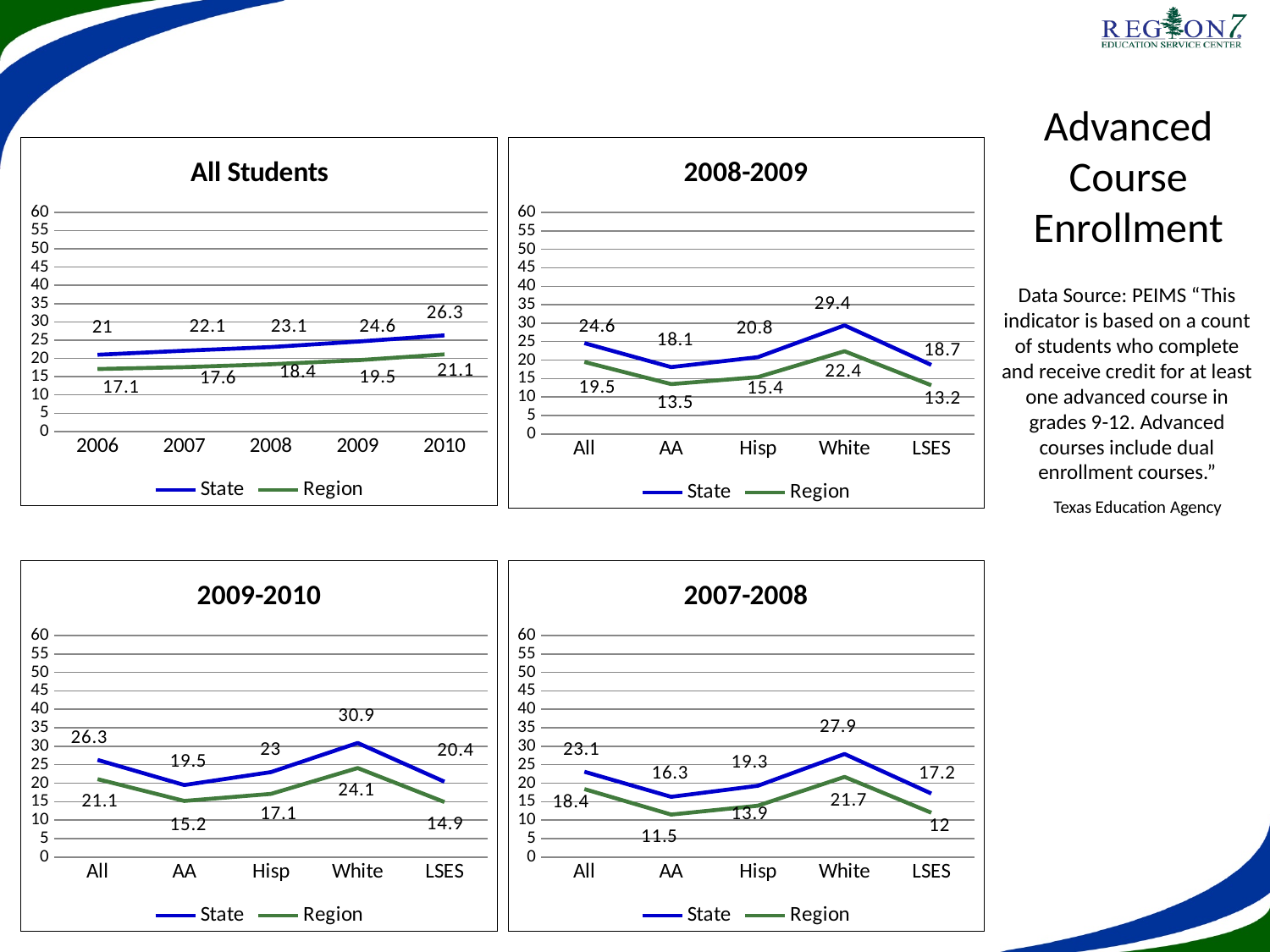
In the '2008-2009' chart, what is the difference between the State and Region values for All? 5.1 How many series does the legend of the '2007-2008' chart list? 2 In the 'All Students' chart, what is the State value for 2010? 26.3 In the '2009-2010' chart, which category has the highest State value? White In the 'All Students' chart, what is the Region value for 2006? 17.1 In the '2008-2009' chart, which category has the lowest Region value? LSES In the 'All Students' chart, does the State line rise or fall from 2006 to 2010? rise In the '2007-2008' chart, what is the Region value for AA? 11.5 In the '2009-2010' chart, what is the Region value for Hisp? 17.1 In the '2007-2008' chart, is the State value for White larger or the Region value for White? State What kind of chart is the '2009-2010' chart? line chart In the '2008-2009' chart, what is the State value for White? 29.4